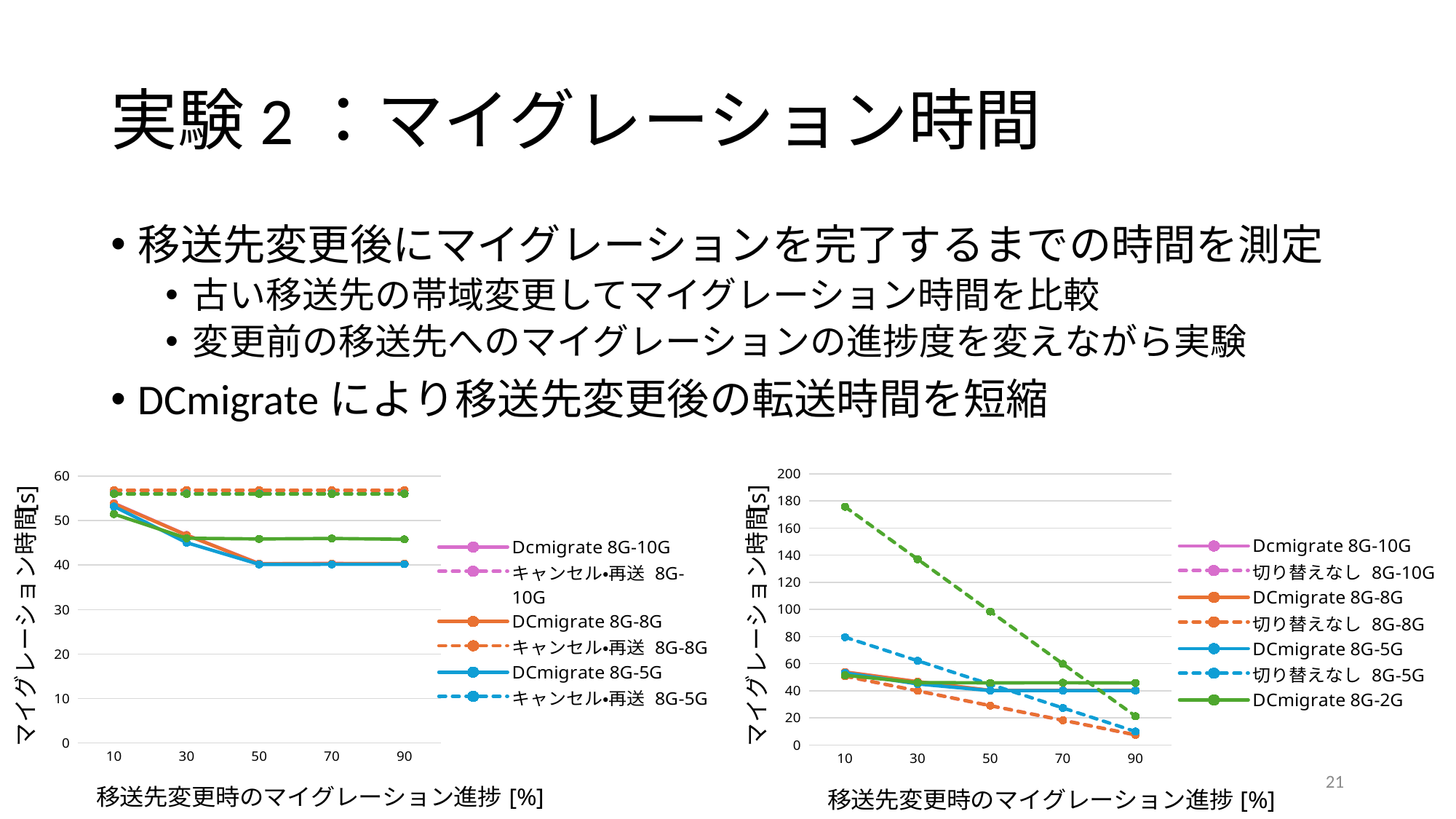
What kind of chart is the right chart on the slide? line chart In the left chart, is the value for キャンセル•再送 8G-8G at 10% greater or less than 50? greater In the right chart, is the value for 切り替えなし 8G-8G at 90% greater or less than 20? less How many series does the legend of the left chart list? 6 In the left chart, does the DCmigrate 8G-5G series rise or fall from 10% to 50%? fall In the left chart, is the value for DCmigrate 8G-5G at 90% greater or less than 50? less What is the x-axis label of the right chart? 移送先変更時のマイグレーション進捗 [%] How many series does the legend of the right chart list? 7 What kind of chart is the left chart on the slide? line chart In the right chart, does the 切り替えなし 8G-5G series rise or fall along the x axis? fall How many x-axis points are plotted for each series in the left chart? 5